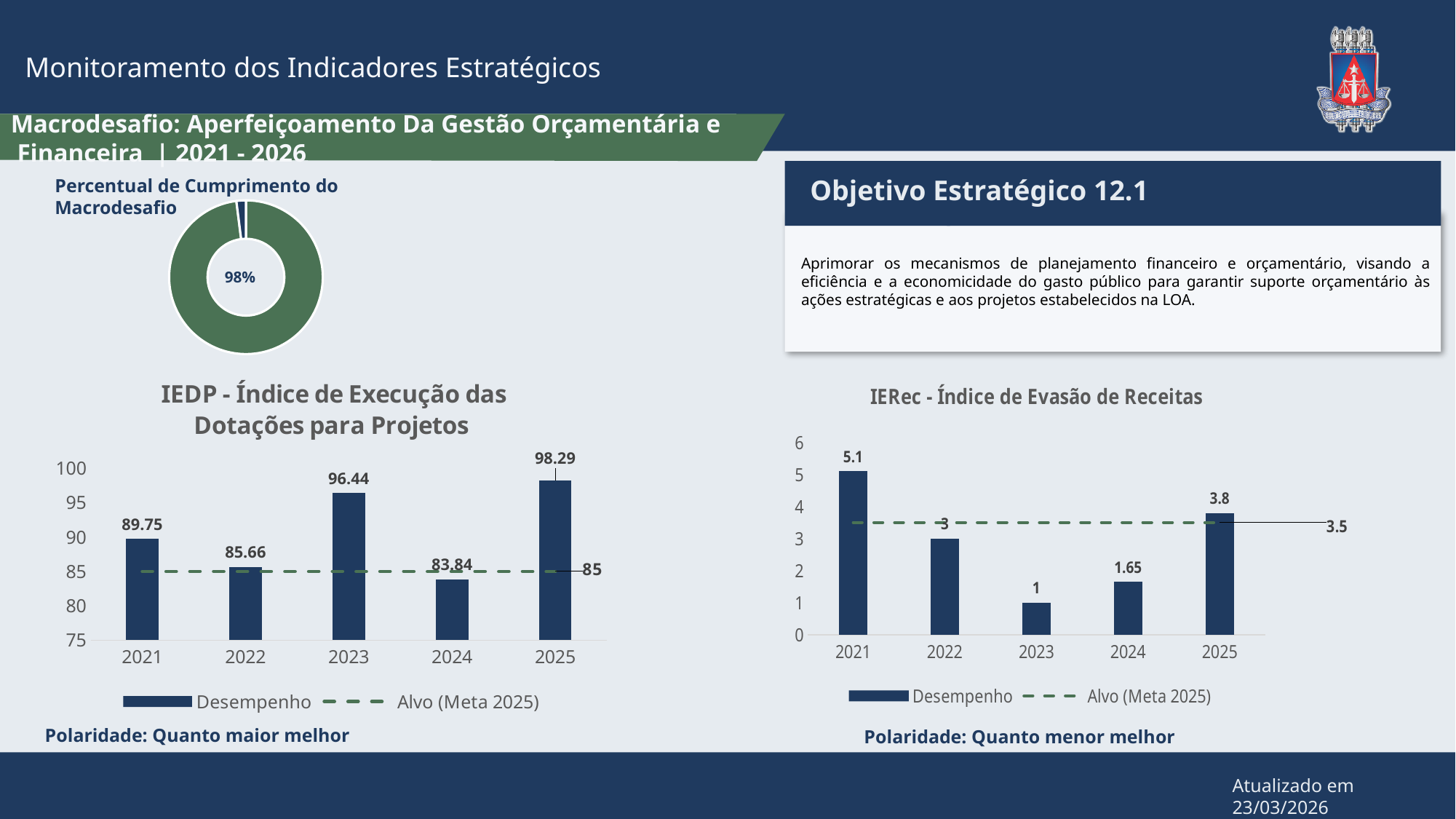
In the Percentual de Cumprimento do Macrodesafio chart, what percentage is shown in the centre of the donut? 98% In the IERec - Índice de Evasão de Receitas chart, what is the Desempenho value for 2024? 1.65 In the IERec - Índice de Evasão de Receitas chart, which year has the highest Desempenho value? 2021 In the IEDP - Índice de Execução das Dotações para Projetos chart, which year has the highest Desempenho value? 2025 In the IEDP - Índice de Execução das Dotações para Projetos chart, which year has the lowest Desempenho value? 2024 In the IERec - Índice de Evasão de Receitas chart, is the 2025 Desempenho value larger or smaller than the Alvo (Meta 2025) value? larger In the IEDP - Índice de Execução das Dotações para Projetos chart, what is the Alvo (Meta 2025) value? 85 In the IERec - Índice de Evasão de Receitas chart, how many years are shown on the x axis? 5 In the IERec - Índice de Evasão de Receitas chart, which year has the lowest Desempenho value? 2023 How many series does the legend of the IEDP - Índice de Execução das Dotações para Projetos chart list? 2 In the IEDP - Índice de Execução das Dotações para Projetos chart, what is the Desempenho value for 2023? 96.44 In the IEDP - Índice de Execução das Dotações para Projetos chart, what is the difference between the 2025 and 2024 Desempenho values? 14.45